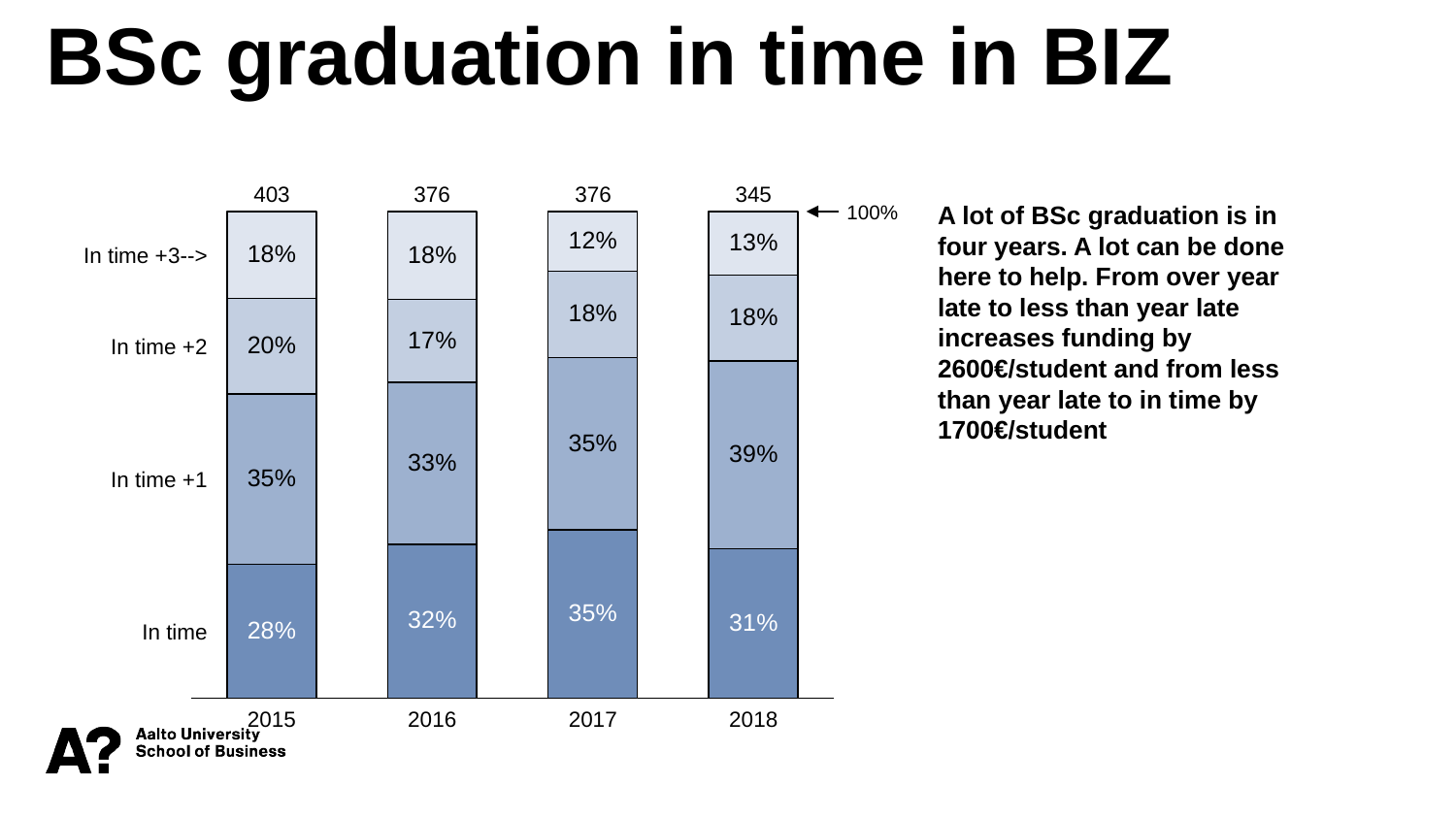
Which year has the lowest 'In time' share? 2015 By how many percentage points does the 'In time' share in 2016 exceed that in 2015? 4 percentage points What is the 'In time +3-->' share for 2017? 12% How many years are shown on the x axis? 4 Which year has the lowest number printed above its bar? 2018 Which year has the larger 'In time +1' share, 2017 or 2018? 2018 What is the 'In time' share for 2015? 28% What number is printed above the 2015 bar? 403 What type of chart is shown on the slide? Stacked bar chart Which year has the highest 'In time' share? 2017 What is the 'In time +1' share for 2018? 39% What is the 'In time +2' share for 2016? 17%